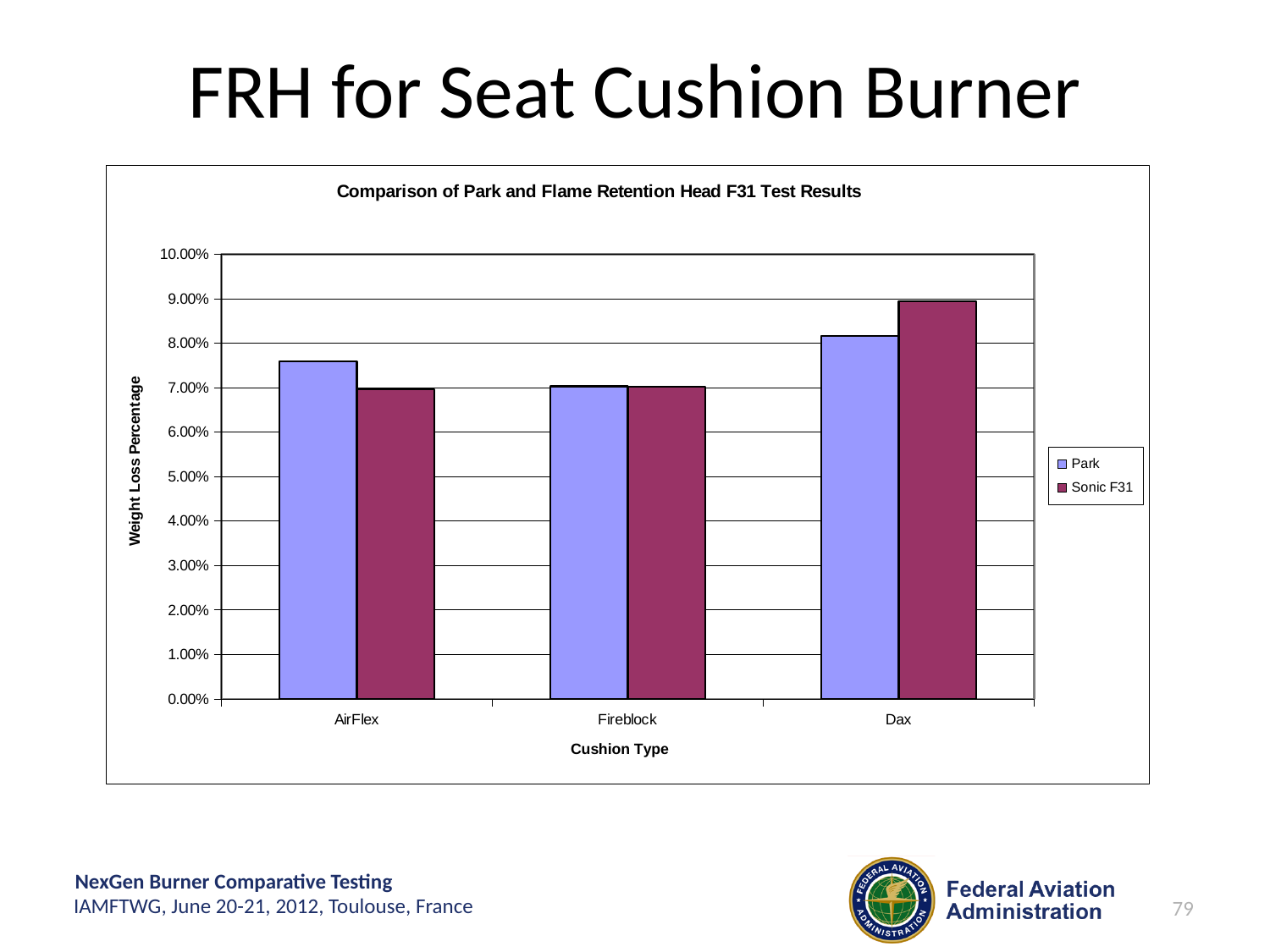
For AirFlex, which series has the larger weight loss percentage, Park or Sonic F31? Park What kind of chart is shown on the slide? bar chart Is the Park value for AirFlex greater or less than 8.00%? less Which cushion type has the lowest Park weight loss percentage? Fireblock Which cushion type has the highest Sonic F31 weight loss percentage? Dax How many series does the legend list? 2 For Dax, which series has the larger weight loss percentage, Park or Sonic F31? Sonic F31 How many cushion types are shown on the x axis? 3 Which cushion type has the lowest Sonic F31 weight loss percentage? AirFlex Is the Sonic F31 value for Dax greater or less than 8.00%? greater Which cushion type has the highest Park weight loss percentage? Dax What is the title of the chart? Comparison of Park and Flame Retention Head F31 Test Results